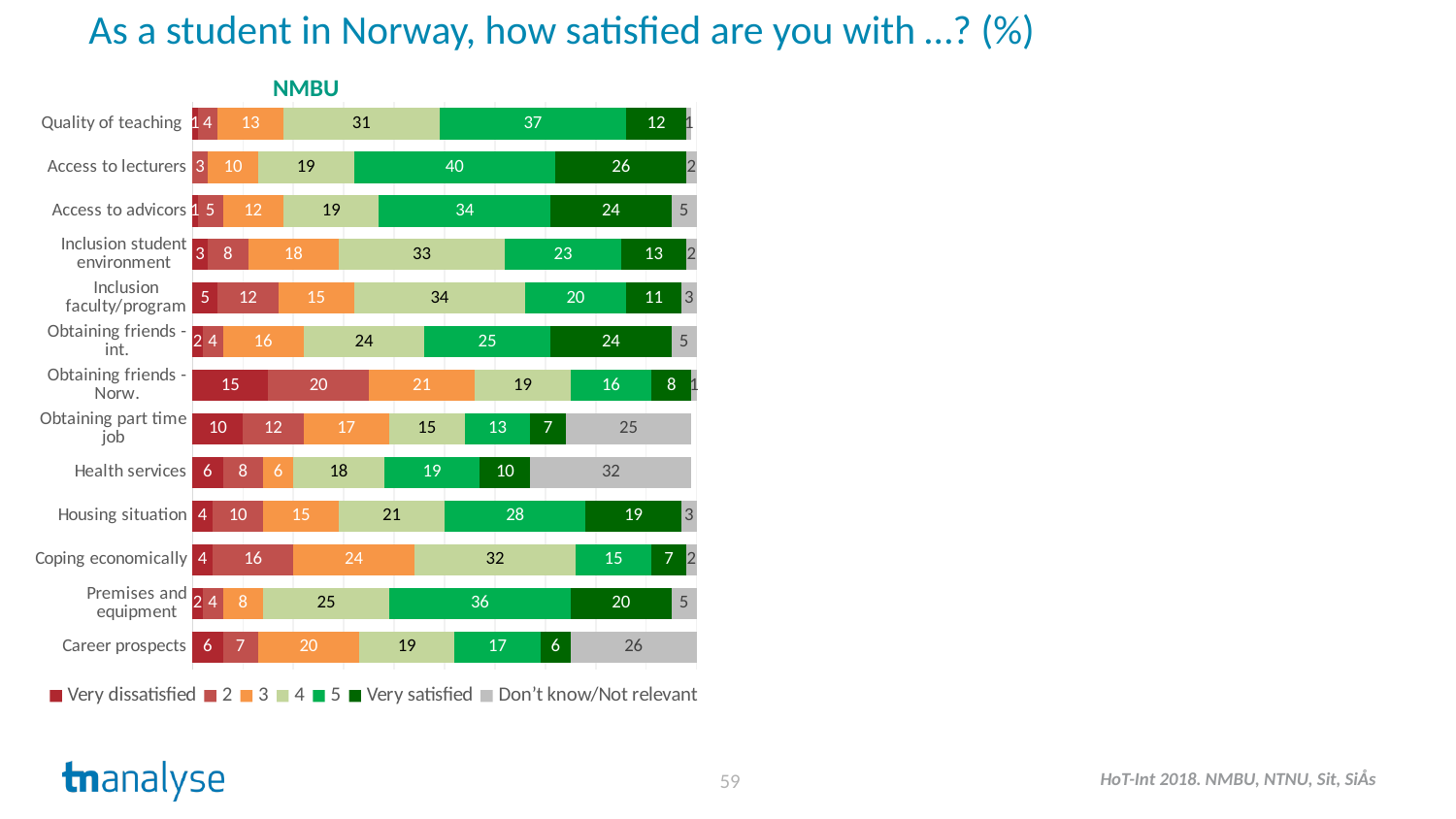
What kind of chart is shown on the slide? Stacked bar chart What is the 'Very satisfied' value for Access to lecturers? 26 Which category has the highest value for '5'? Access to lecturers Which category has the highest 'Don't know/Not relevant' value? Health services What is the 'Don't know/Not relevant' value for Health services? 32 What is the title shown above the chart? NMBU What is the difference between the '4' value for Coping economically and the '4' value for Career prospects? 13 Which is larger: the 'Very satisfied' value for Housing situation or for Coping economically? Housing situation What is the 'Very dissatisfied' value for Obtaining friends - Norw.? 15 How many series does the legend list? 7 What is the value for '5' for Access to lecturers? 40 How many categories (survey items) are listed on the chart? 13